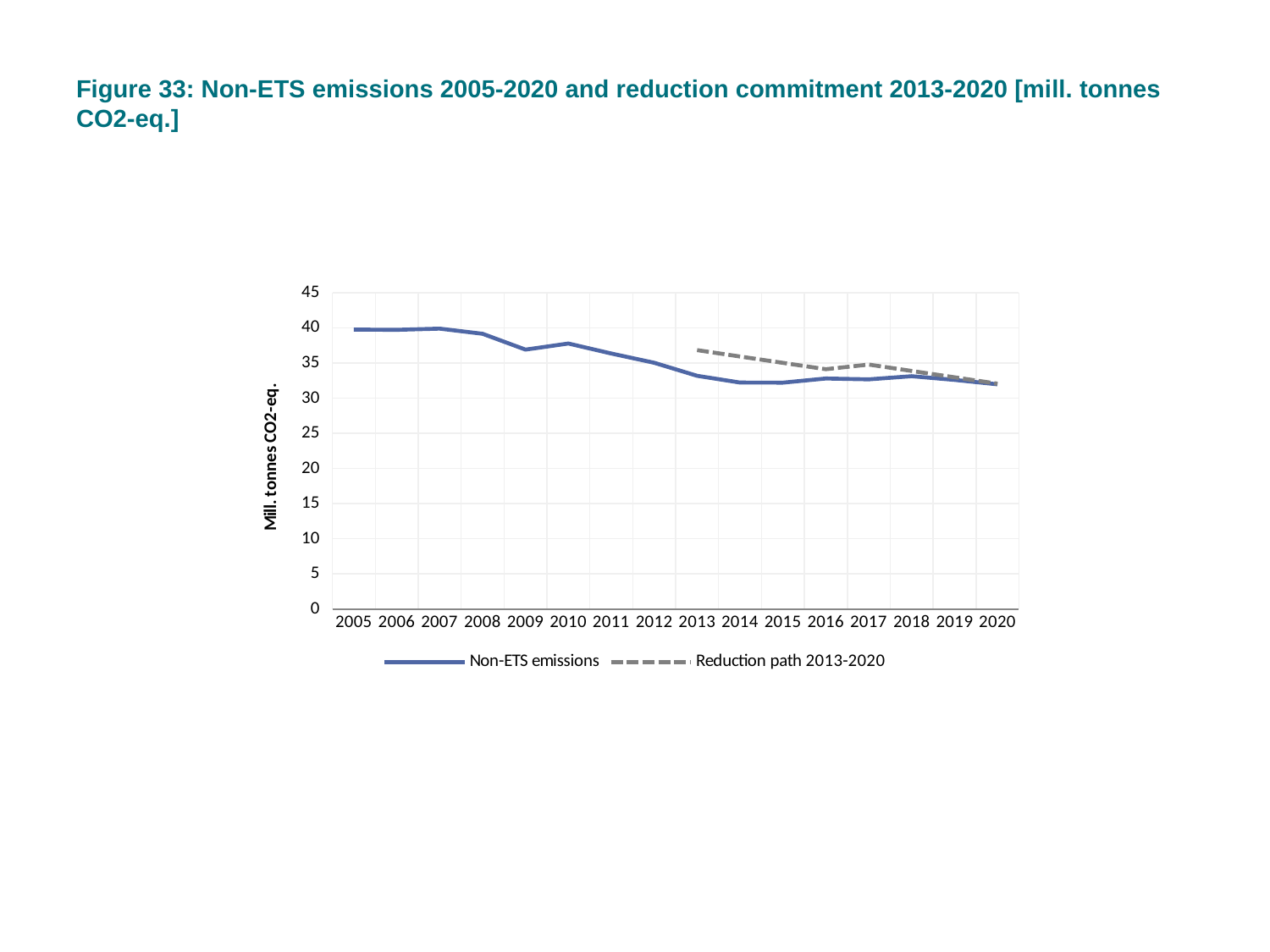
Is the value for the Reduction path 2013-2020 in 2013 greater or less than 35? greater Which is larger: Non-ETS emissions in 2005 or in 2014? 2005 Is the value for Non-ETS emissions in 2014 greater or less than 35? less How many series does the legend list? 2 Do Non-ETS emissions generally rise or fall from 2005 to 2020? Fall What is the label on the y axis? Mill. tonnes CO2-eq. In 2013, which series has the higher value: Non-ETS emissions or Reduction path 2013-2020? Reduction path 2013-2020 Is the value for Non-ETS emissions in 2009 greater or less than 35? greater What kind of chart is shown on the slide? Line chart How many years are shown on the x axis? 16